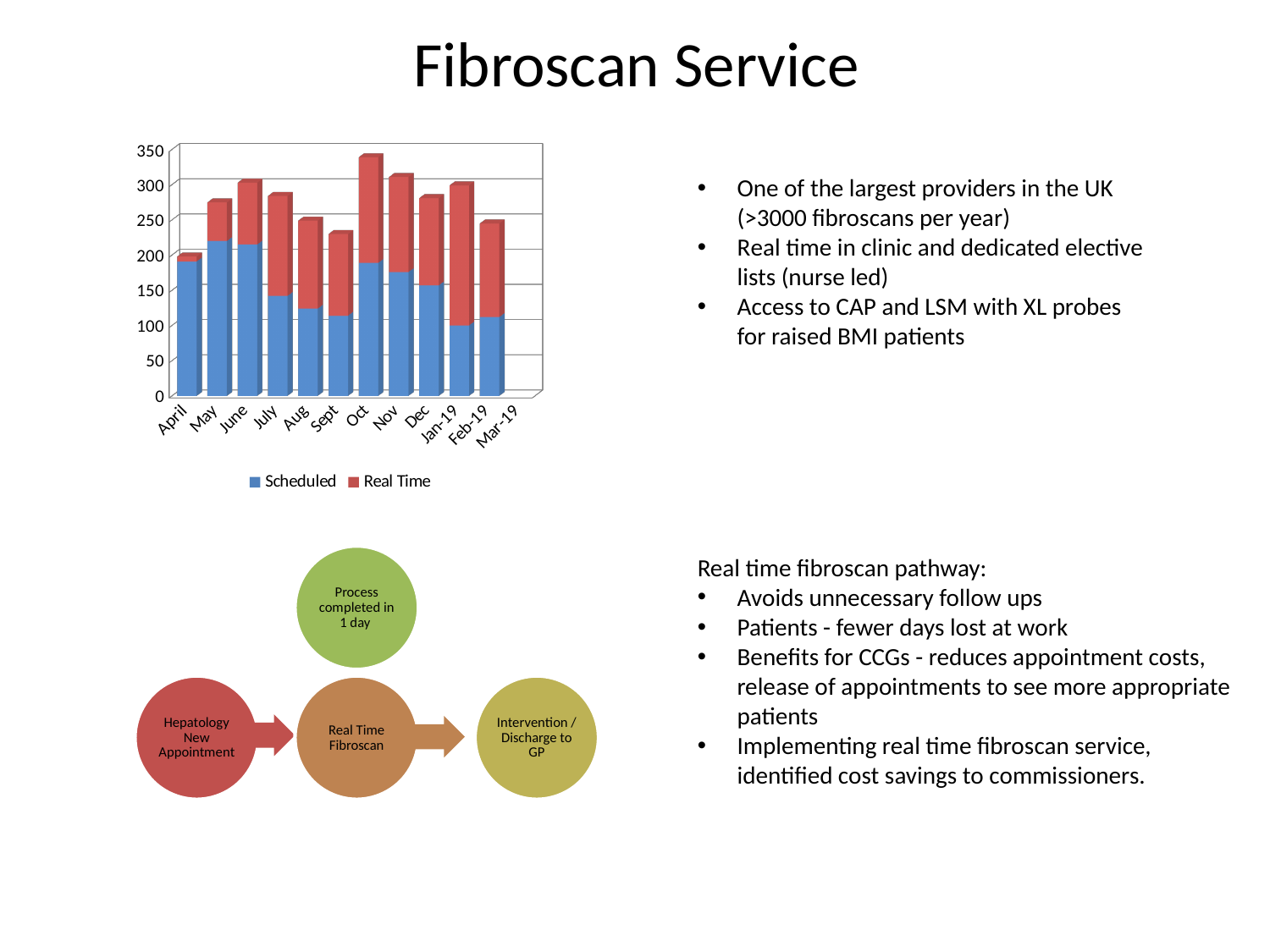
Is the Scheduled value for Sept greater or less than 150? less Is the Scheduled value for May greater or less than 200? greater Which colour represents the Scheduled series in the chart? Blue Which is larger, the Scheduled value for May or the Scheduled value for Jan-19? May Among the months with a bar shown, which has the shortest stacked bar? April How many series does the chart's legend list? 2 Is the total stacked bar for Sept greater or less than 250? less How many month labels are shown on the chart's x axis? 12 What kind of chart is shown on the slide? Stacked bar chart Which month has the tallest stacked bar in the chart? Oct What are the two series named in the chart's legend? Scheduled and Real Time